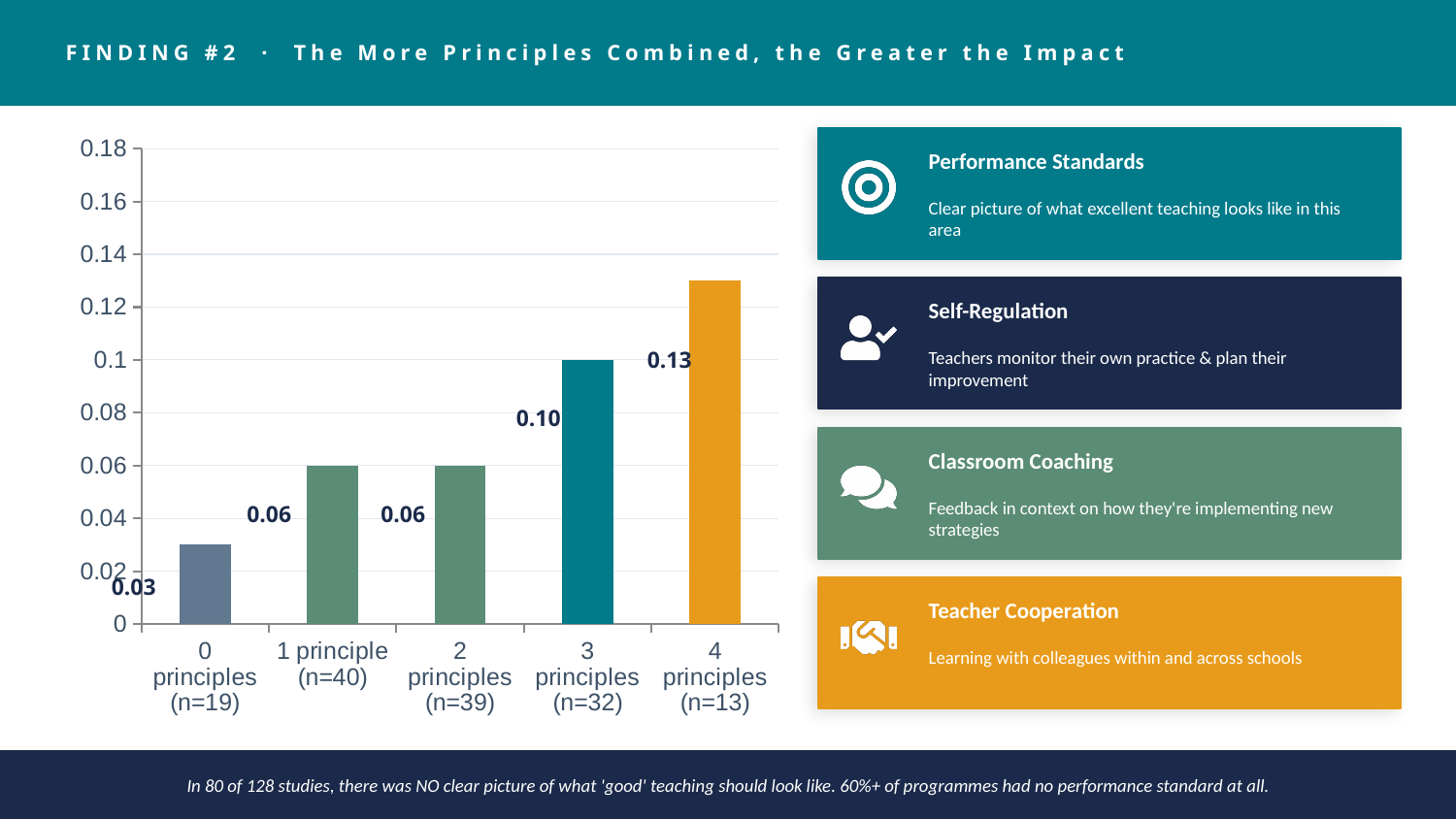
Which category has the highest value? 4 principles (n=13) Which category has the lowest value? 0 principles (n=19) How many categories are shown on the x axis? 5 What is the value for 0 principles (n=19)? 0.03 What is the value for 3 principles (n=32)? 0.10 Which is larger, the value for 1 principle or the value for 3 principles? 3 principles Do the values generally rise or fall from 0 principles to 4 principles? rise What is the value for 4 principles (n=13)? 0.13 What kind of chart is shown on the slide? bar chart What is the difference between the values for 3 principles and 2 principles? 0.04 What is the difference between the values for 4 principles and 0 principles? 0.10 Is the value for 4 principles greater or less than 0.12? greater